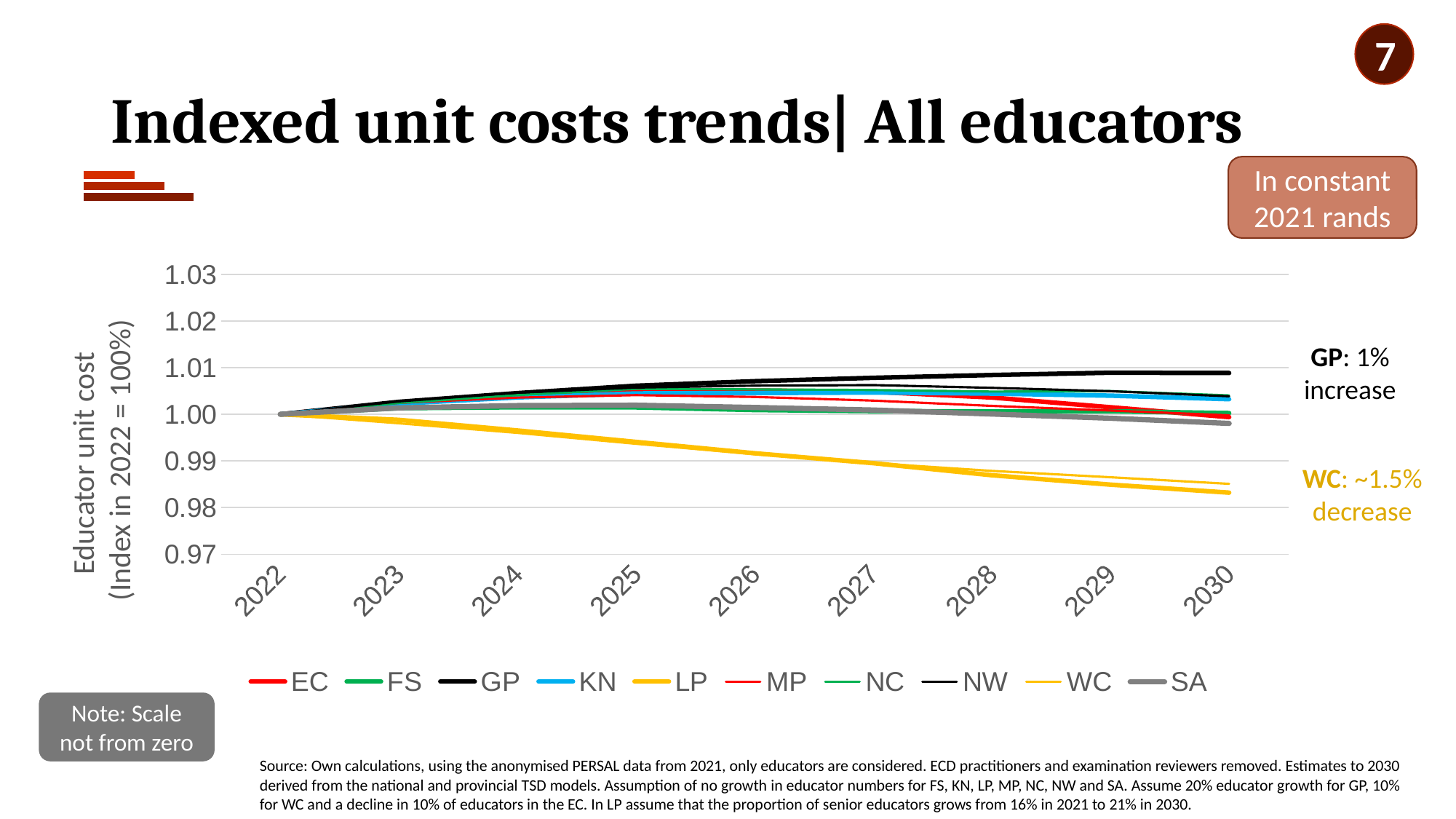
Does the GP series rise or fall from 2022 to 2030? rise How many years are shown along the x axis? 9 Is the value for LP in 2030 greater or less than 0.99? less What kind of chart is shown on the slide? line chart Is the value for GP in 2030 greater or less than 1.00? greater Does the LP series rise or fall from 2022 to 2030? fall What is the label on the y axis of the chart? Educator unit cost (Index in 2022 = 100%) What is the indexed unit cost value for all series in 2022? 1.00 Is the value for WC in 2030 greater or less than 0.99? less How many series does the legend list? 10 Which is larger in 2030, the value for GP or the value for LP? GP What is the title of the slide's chart? Indexed unit costs trends| All educators